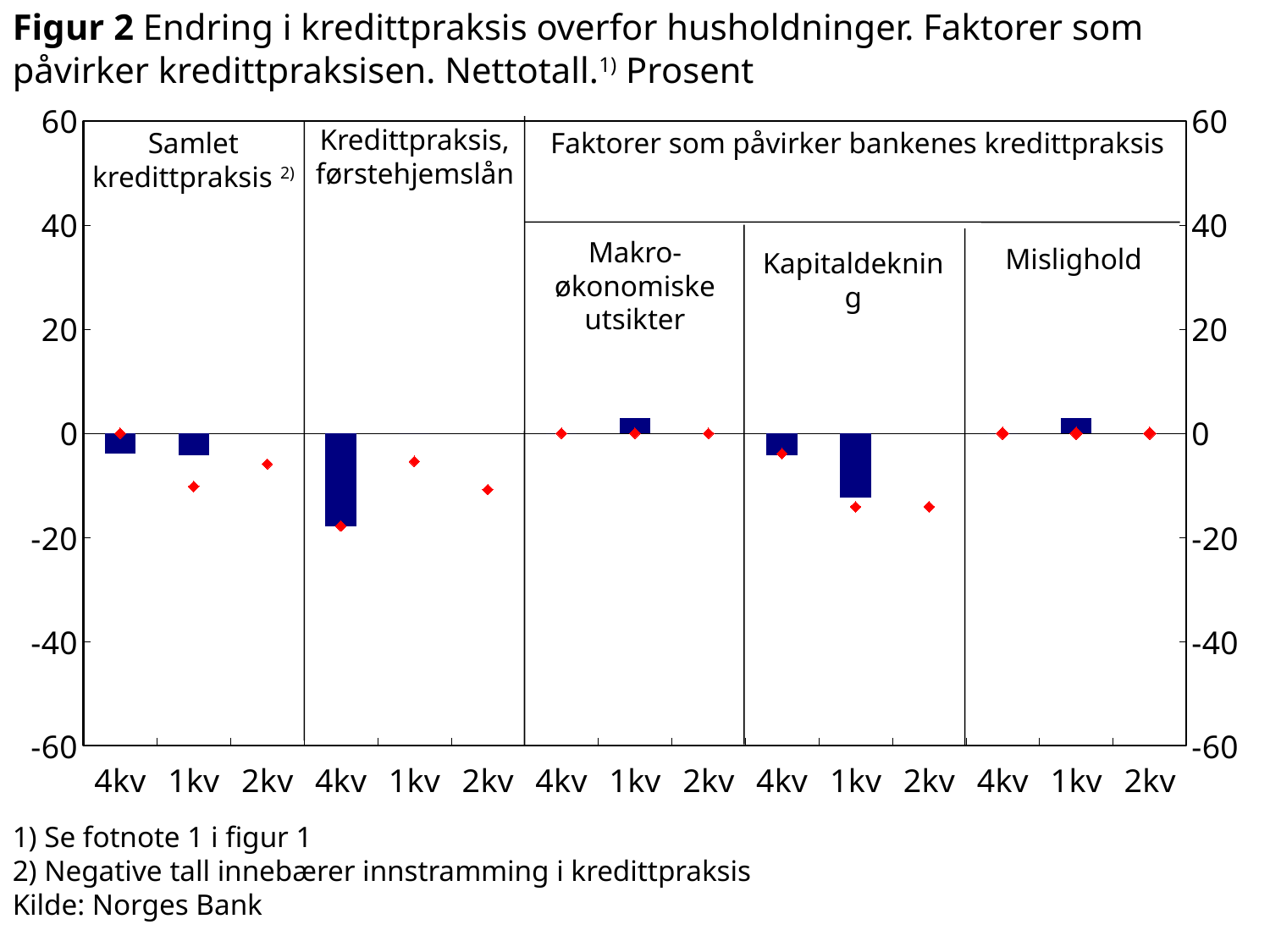
Which bar is lower: 1kv under Kapitaldekning or 1kv under Samlet kredittpraksis? 1kv under Kapitaldekning Is the bar for 1kv under Makroøkonomiske utsikter greater or less than 0? greater How many quarter categories are shown along the x axis in total? 15 What kind of chart is shown on the slide? Bar chart What is the maximum value shown on the vertical axis? 60 What source is given for the chart? Norges Bank Is the red marker for 1kv under Samlet kredittpraksis greater or less than 0? less Which bar is higher: 4kv under Kredittpraksis, førstehjemslån or 4kv under Samlet kredittpraksis? 4kv under Samlet kredittpraksis How many panels (groups) is the chart divided into? 5 Is the bar for 4kv under Kredittpraksis, førstehjemslån greater or less than -10? less Which bar is the lowest in the chart? 4kv under Kredittpraksis, førstehjemslån